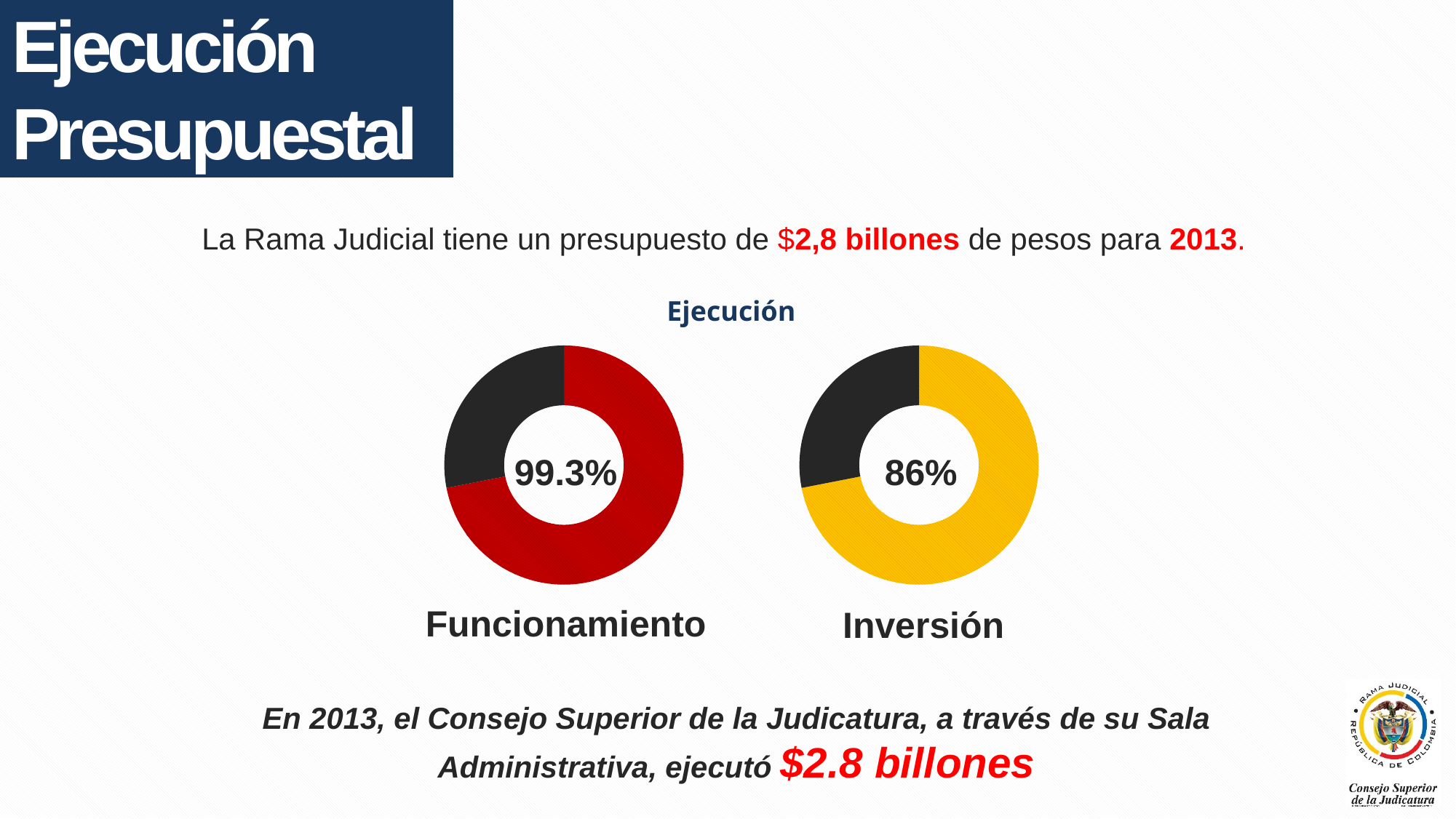
What execution percentage is shown in the centre of the Funcionamiento donut chart? 99.3% Which category shows the highest execution percentage on the slide? Funcionamiento What execution percentage is shown in the centre of the Inversión donut chart? 86% What is the title printed above the two donut charts? Ejecución What is the difference in percentage points between the Funcionamiento execution (99.3%) and the Inversión execution (86%)? 13.3 percentage points Is the execution percentage for Inversión greater or less than 90%? less How many donut charts are shown on the slide? 2 Which of the two donut charts, Funcionamiento or Inversión, shows the higher execution percentage? Funcionamiento What kind of chart is used to show the execution percentages on the slide? Donut (pie) chart What colour is the main slice of the Inversión donut chart? Yellow Which category shows the lowest execution percentage on the slide? Inversión Is the execution percentage for Funcionamiento greater or less than 95%? greater